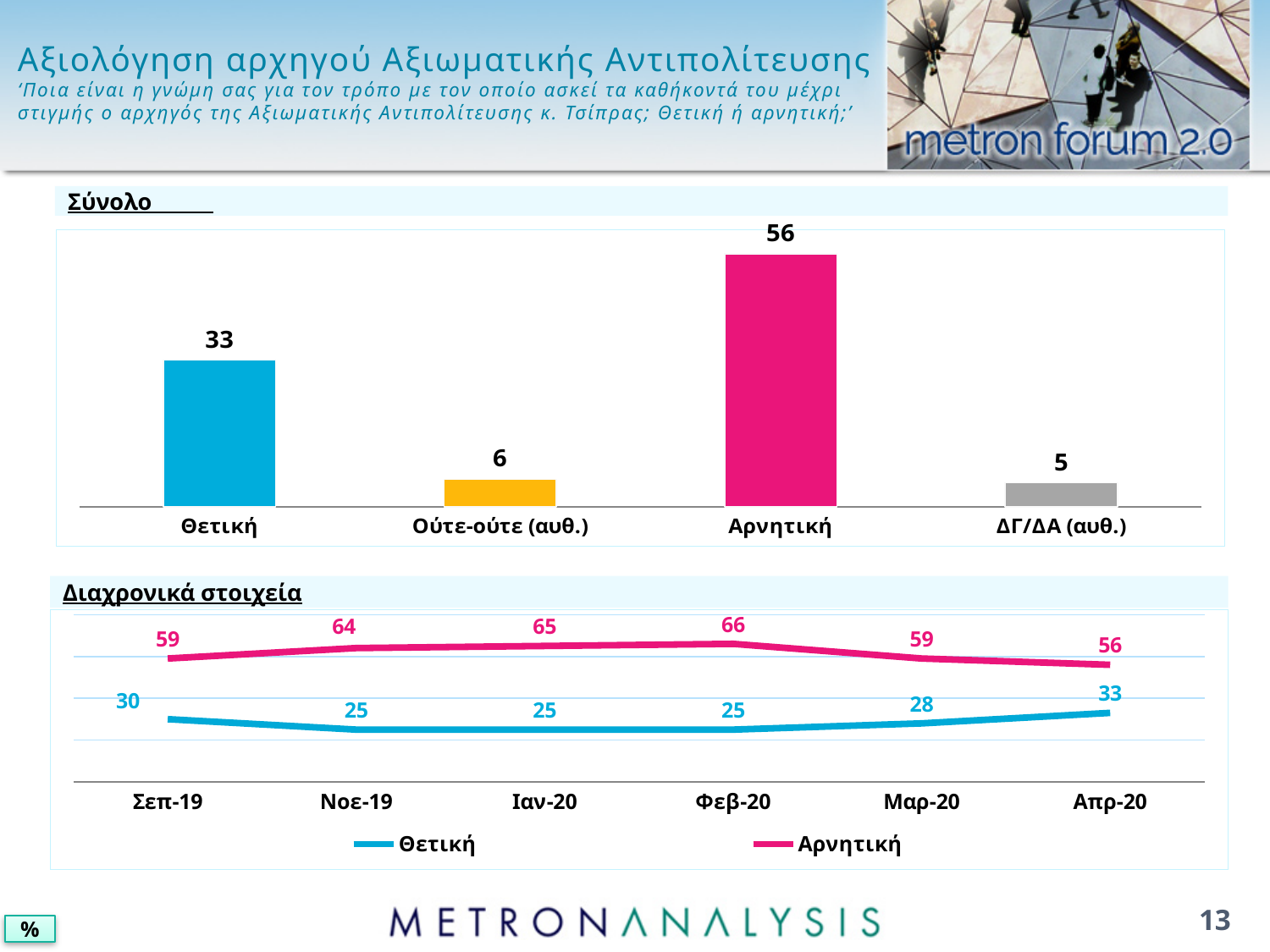
In the 'Διαχρονικά στοιχεία' line chart, what is the value for Θετική in Σεπ-19? 30 In the 'Διαχρονικά στοιχεία' line chart, how many series does the legend list? 2 In the 'Σύνολο' bar chart, how many categories are shown? 4 In the 'Διαχρονικά στοιχεία' line chart, what is the value for Αρνητική in Φεβ-20? 66 In the 'Διαχρονικά στοιχεία' line chart, which is larger in Μαρ-20: Θετική or Αρνητική? Αρνητική In the 'Σύνολο' bar chart, what is the value for Αρνητική? 56 In the 'Διαχρονικά στοιχεία' line chart, how many time points are shown on the x axis? 6 In the 'Σύνολο' bar chart, which category has the lowest value? ΔΓ/ΔΑ (αυθ.) In the 'Διαχρονικά στοιχεία' line chart, does the Αρνητική series rise or fall from Φεβ-20 to Απρ-20? fall In the 'Σύνολο' bar chart, what is the difference between Αρνητική and Θετική? 23 What kind of chart is the 'Σύνολο' chart? bar chart In the 'Σύνολο' bar chart, what is the value for Θετική? 33